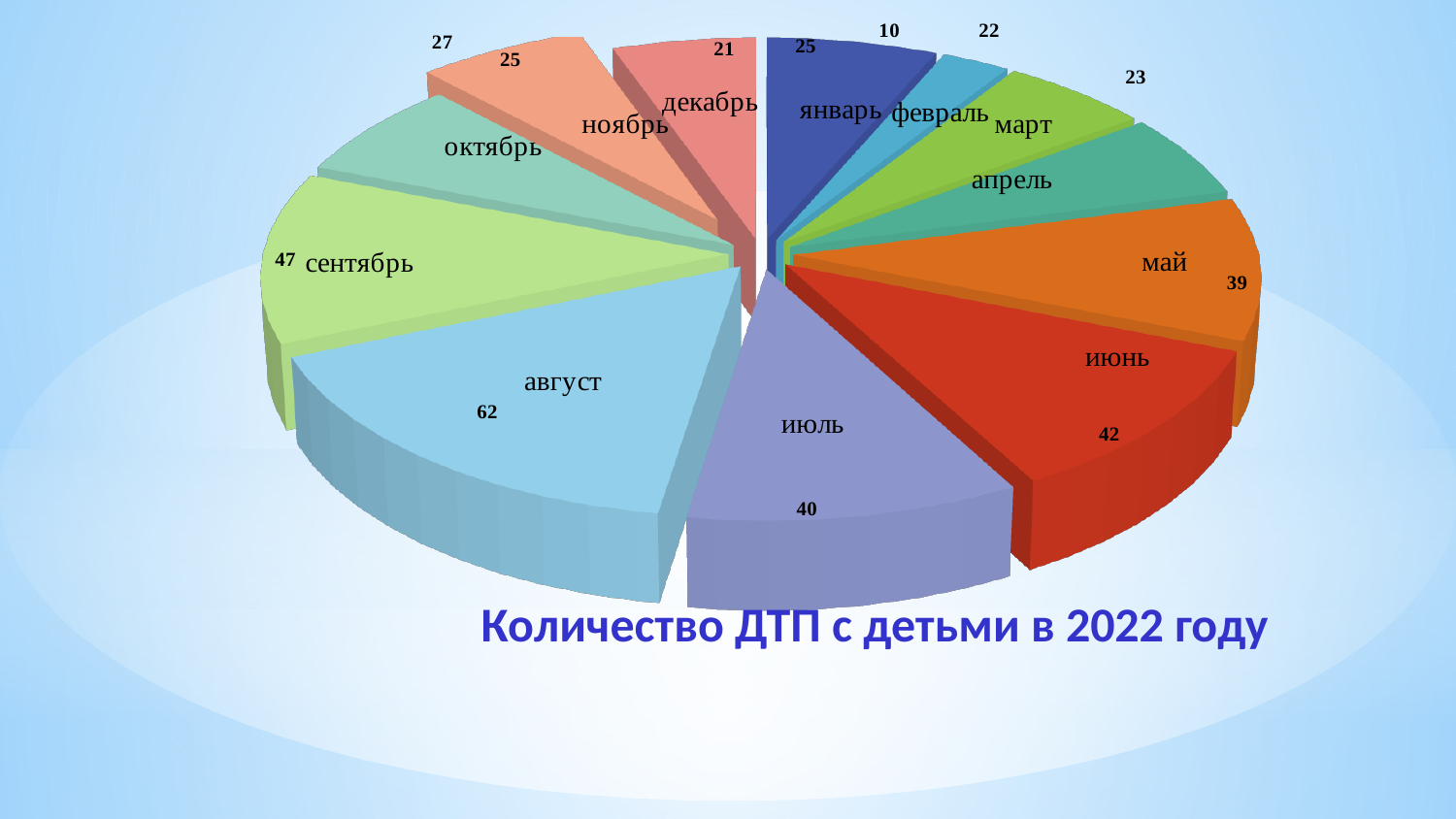
What is the title of the chart? Количество ДТП с детьми в 2022 году How many slices (months) does the pie chart have? 12 What is the value for сентябрь? 47 What is the value for май? 39 Which month has the smallest slice? февраль Which month has the largest slice? август What is the value for август? 62 What is the value for февраль? 10 What kind of chart is shown on the slide? Pie chart What is the difference between the values for август and сентябрь? 15 What is the difference between the values for июнь and май? 3 Which is larger, the value for июнь or the value for июль? июнь